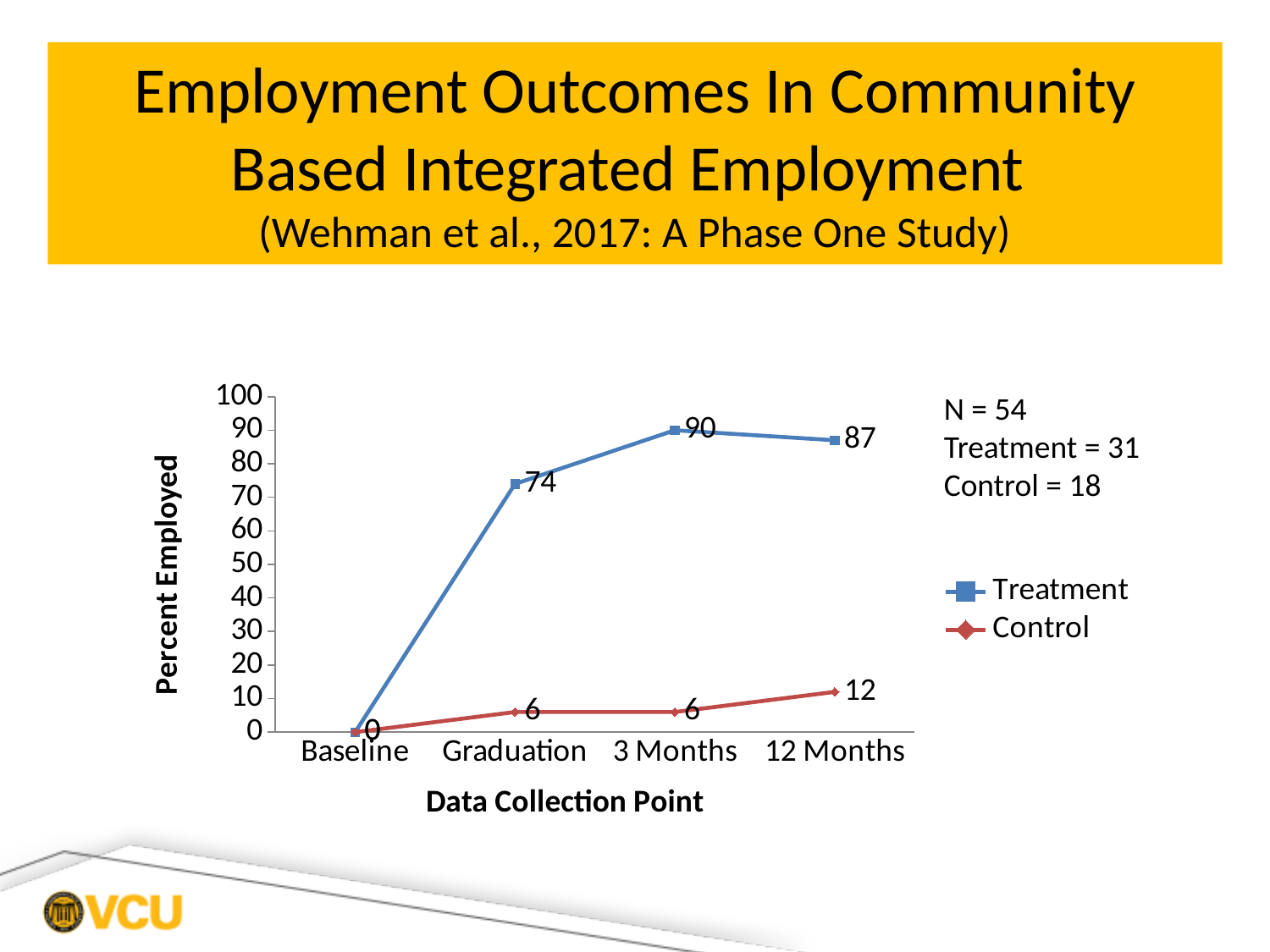
What is the Treatment value at Graduation? 74 How many data collection points are shown on the x axis? 4 What is the Treatment value at 3 Months? 90 What is the label of the y axis? Percent Employed Which is larger at 3 Months, the Treatment value or the Control value? Treatment At which data collection point is the Treatment value highest? 3 Months What is the Control value at Graduation? 6 How many series does the legend list? 2 What is the Control value at 12 Months? 12 What kind of chart is shown on the slide? Line chart At which data collection point is the Control value highest? 12 Months What is the difference between the Treatment and Control values at 12 Months? 75